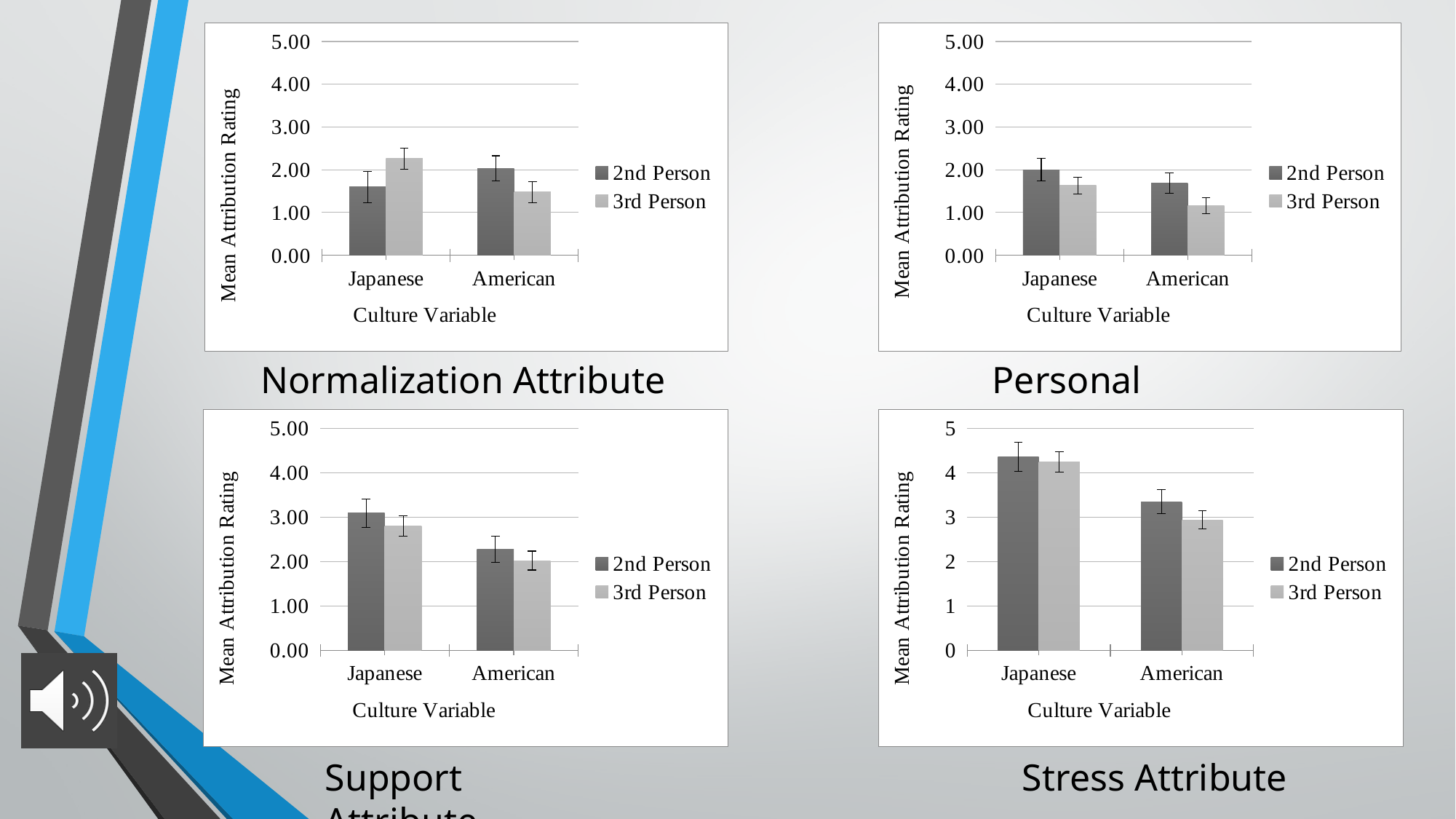
What is the y-axis label of the Stress Attribute chart? Mean Attribution Rating In the Stress Attribute chart, which is larger for 2nd Person: the Japanese value or the American value? Japanese In the Support Attribute chart, is the 3rd Person value for Japanese greater or less than 2.00? greater How many series does the legend of the Personal chart list? 2 What kind of chart is the Normalization Attribute chart? bar chart In the Normalization Attribute chart, which is larger for Japanese: the 2nd Person value or the 3rd Person value? 3rd Person In the Stress Attribute chart, is the 2nd Person value for Japanese greater or less than 4? greater How many categories are shown on the x axis of the Stress Attribute chart? 2 In the Personal chart, is the 3rd Person value for American greater or less than 2.00? less In the Support Attribute chart, do the 2nd Person values rise or fall from Japanese to American? fall In the Personal chart, which bar is the lowest? American, 3rd Person